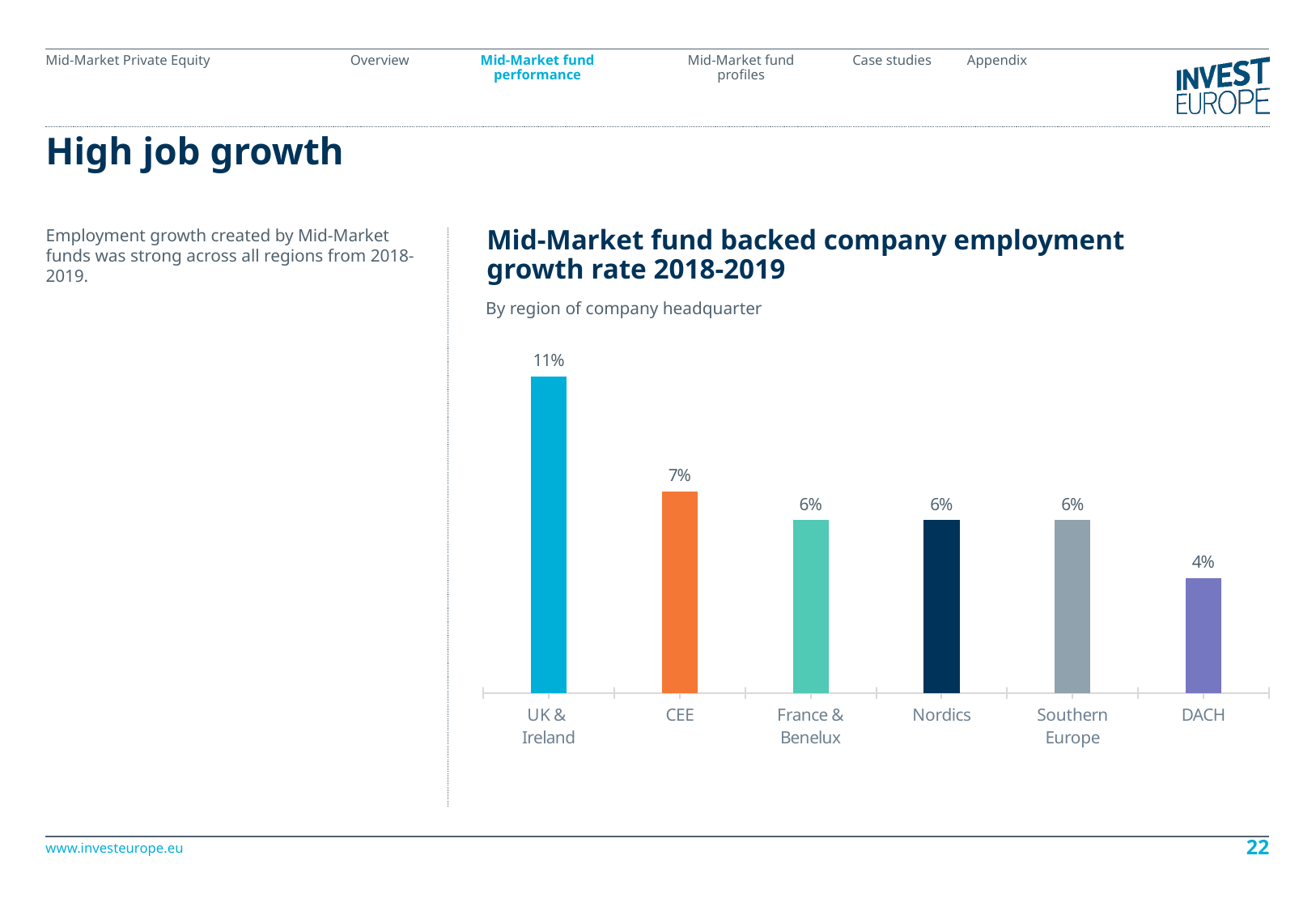
What is the difference between the employment growth rate for Southern Europe and for DACH? 2% Which region has the lowest employment growth rate? DACH How many regions are shown in the chart? 6 What is the employment growth rate for DACH? 4% What kind of chart is shown on the slide? Bar chart Which region has the highest employment growth rate? UK & Ireland What is the employment growth rate for UK & Ireland? 11% What is the employment growth rate for CEE? 7% What is the subtitle shown below the chart title? By region of company headquarter What is the employment growth rate for Nordics? 6% What is the difference between the employment growth rate for UK & Ireland and for CEE? 4% Which has a higher employment growth rate, CEE or France & Benelux? CEE